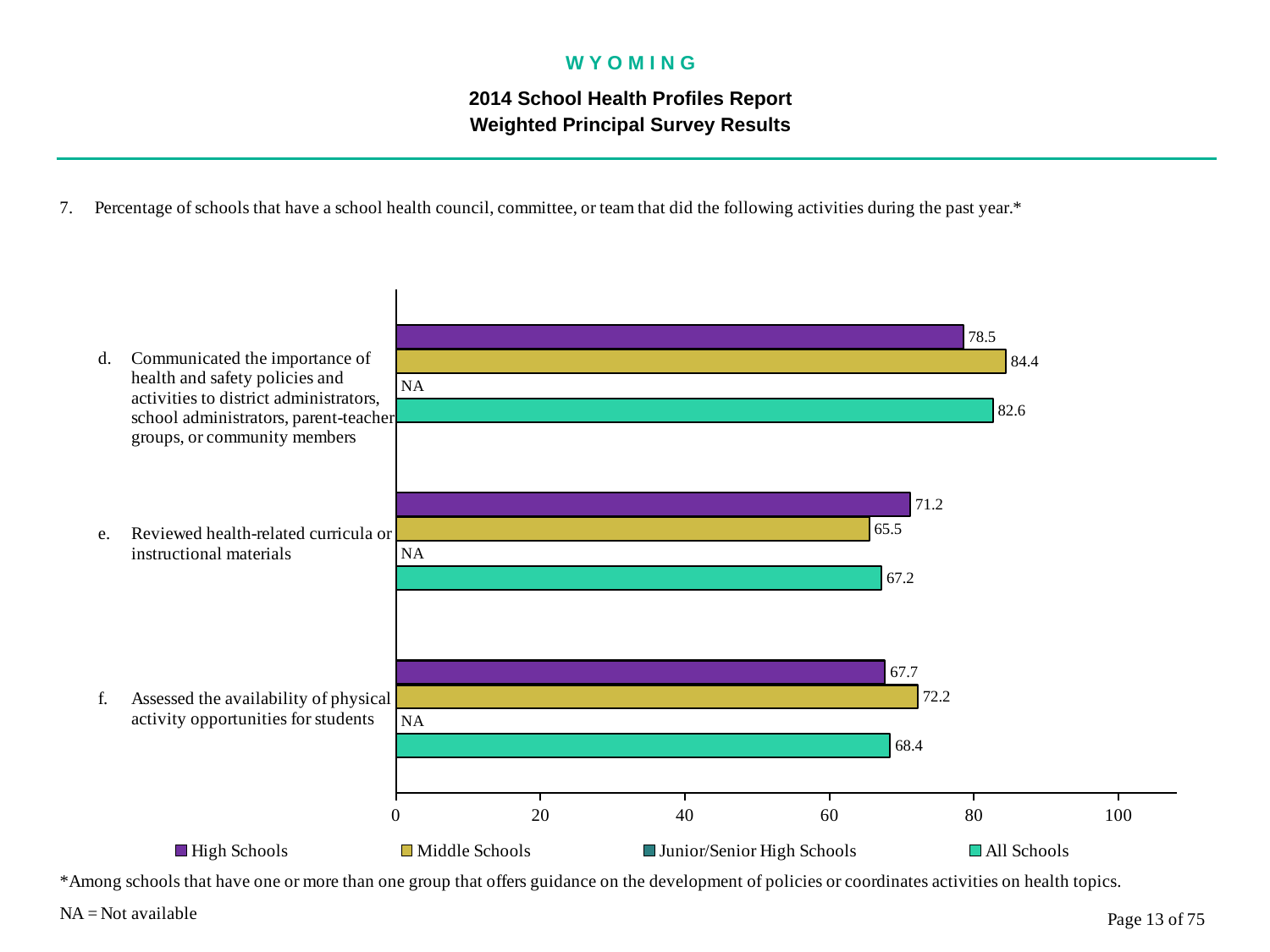
Which school type has the lowest value for 'Reviewed health-related curricula or instructional materials'? Middle Schools What is the value for High Schools for 'Reviewed health-related curricula or instructional materials'? 71.2 What is the value for All Schools for 'Assessed the availability of physical activity opportunities for students'? 68.4 What kind of chart is shown on the slide? bar chart What is the value for Middle Schools for 'Communicated the importance of health and safety policies and activities to district administrators, school administrators, parent-teacher groups, or community members'? 84.4 What is the difference between the Middle Schools and High Schools values for 'Assessed the availability of physical activity opportunities for students'? 4.5 Which school type has the highest value for 'Communicated the importance of health and safety policies and activities to district administrators, school administrators, parent-teacher groups, or community members'? Middle Schools How many series does the legend list? 4 What is shown for Junior/Senior High Schools for 'Reviewed health-related curricula or instructional materials'? NA Is the All Schools value for 'Communicated the importance of health and safety policies and activities to district administrators, school administrators, parent-teacher groups, or community members' greater or less than 80? greater How many activity categories are shown on the chart? 3 Which is larger for 'Reviewed health-related curricula or instructional materials': the High Schools value or the All Schools value? High Schools